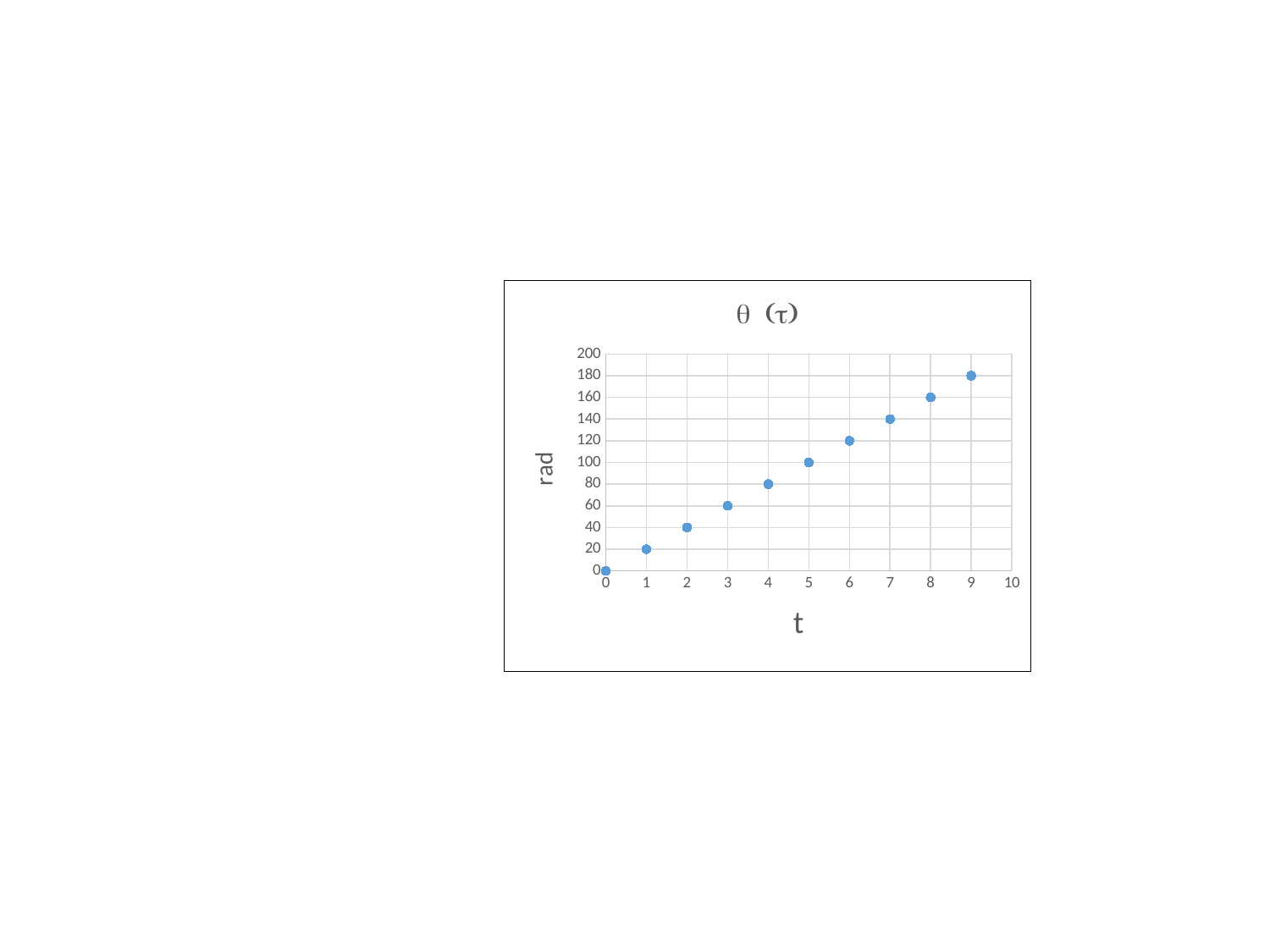
How many data points are plotted on the chart? 10 What is the difference between the values at t = 8 and t = 3? 100 What kind of chart is shown on the slide? scatter chart Which is larger, the value at t = 4 or the value at t = 7? t = 7 What is the title of the chart? θ (τ) At which value of t is the plotted value highest? 9 What is the value at t = 2? 40 What is the value at t = 9? 180 Do the plotted values rise or fall as t increases? rise What is the value at t = 5? 100 At which value of t is the plotted value lowest? 0 What is the label on the vertical axis of the chart? rad